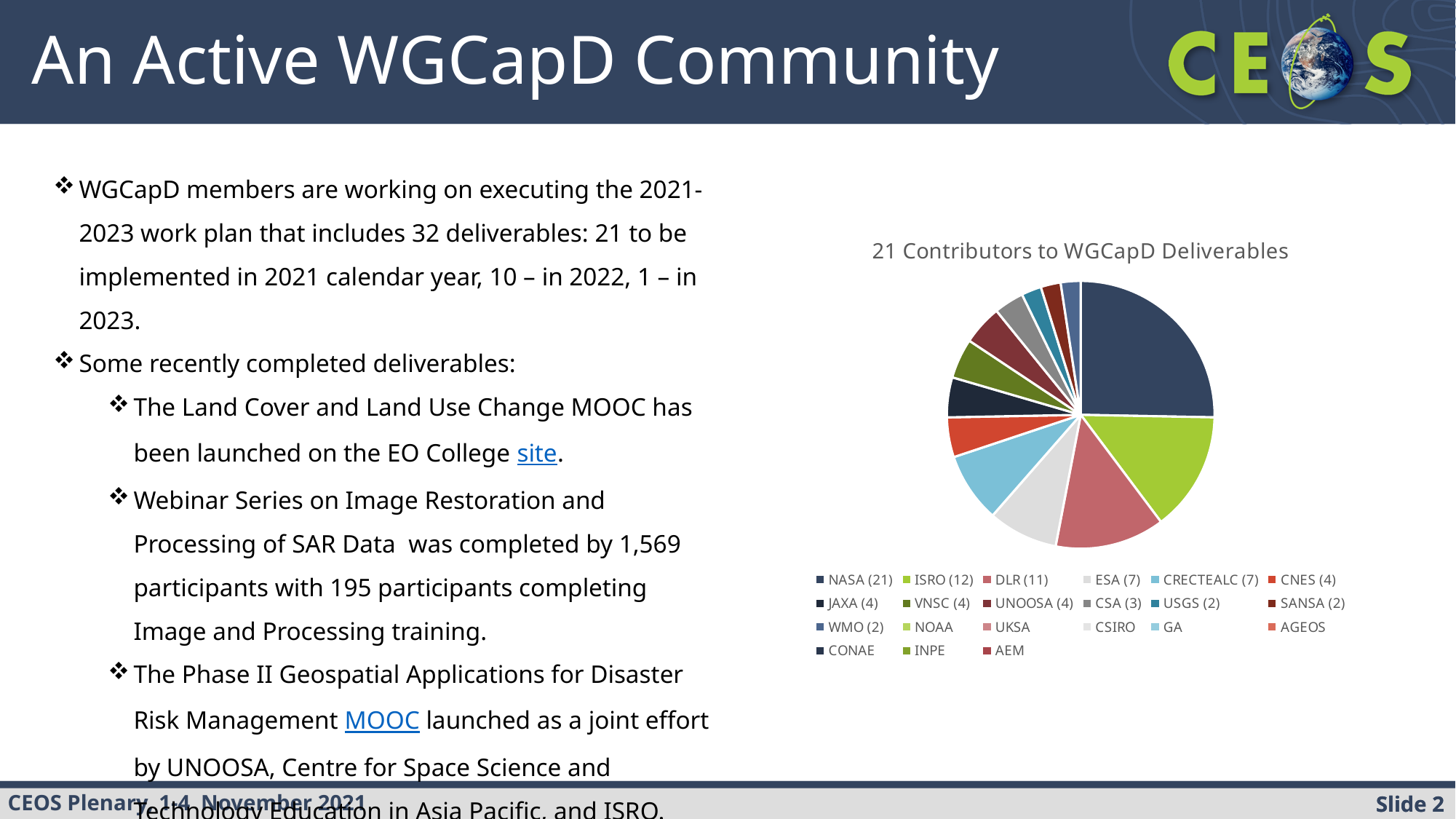
Which has a larger value, ESA or CNES? ESA What is the difference between the values for NASA and ISRO? 9 What value is shown for DLR in the chart legend? 11 What value is shown for ISRO in the chart legend? 12 Which has a larger value, USGS or CSA? CSA What is the difference between the values for DLR and ESA? 4 How many contributors are listed in the chart legend? 21 What kind of chart is shown on the slide? pie chart What is the title of the chart? 21 Contributors to WGCapD Deliverables What value is shown for CSA in the chart legend? 3 How many deliverables is NASA credited with in the chart legend? 21 Which contributor has the largest slice of the pie? NASA